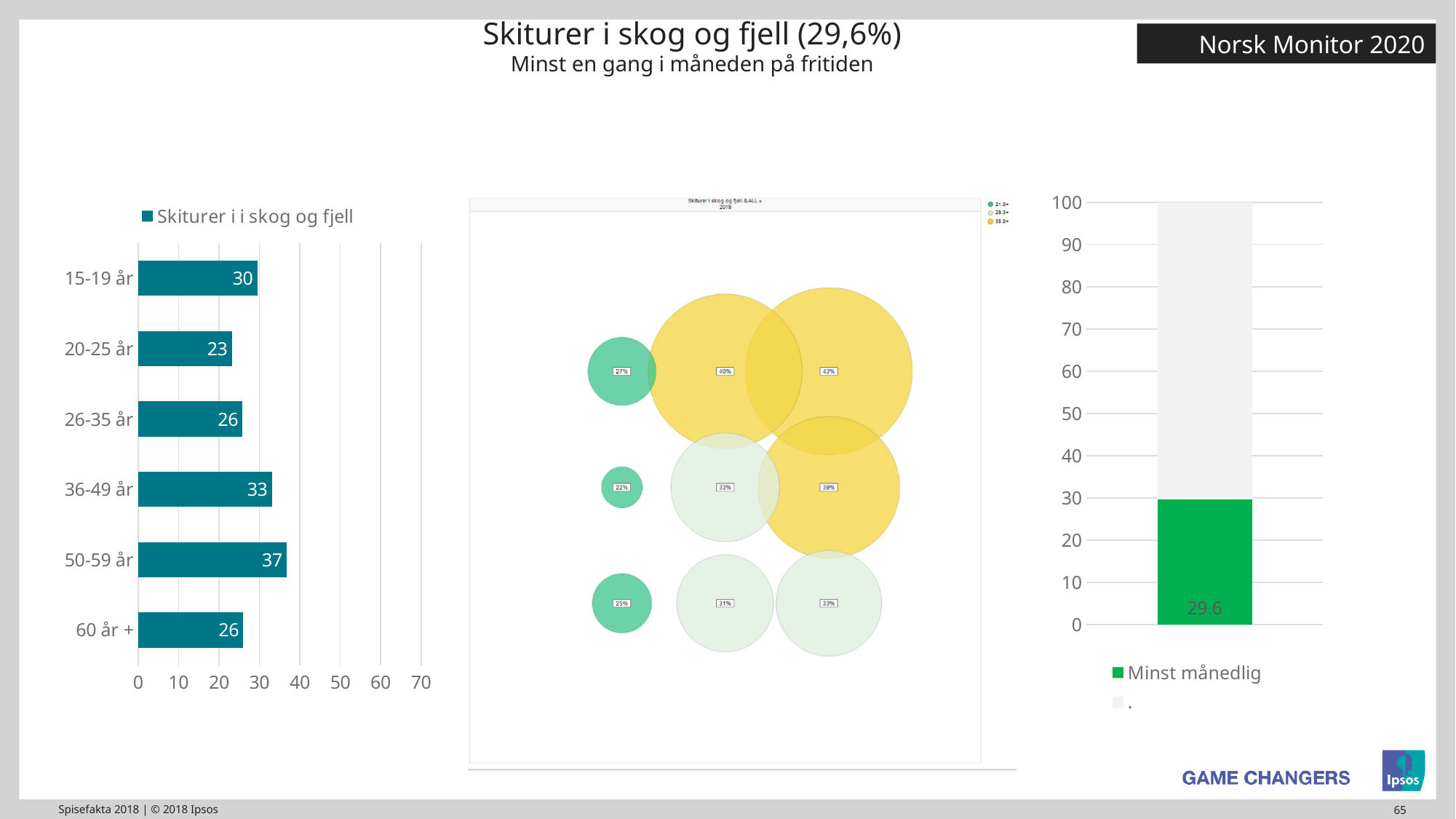
In the left bar chart, which age group has the highest value? 50-59 år In the left bar chart, which is larger, the value for 36-49 år or the value for 26-35 år? 36-49 år In the left bar chart, what is the value for 20-25 år? 23 In the right bar chart, what is the value for Minst månedlig? 29.6 In the left bar chart, which age group has the lowest value? 20-25 år In the middle bubble chart, how many bubbles are plotted? 9 In the left bar chart, what is the difference between the values for 50-59 år and 15-19 år? 7 What kind of chart is the chart on the left of the slide? Bar chart In the left bar chart, how many age groups are shown? 6 In the left bar chart, what is the value for 50-59 år? 37 In the left bar chart, what is the legend entry? Skiturer i i skog og fjell In the right bar chart, is the value for Minst månedlig greater or less than 40? less